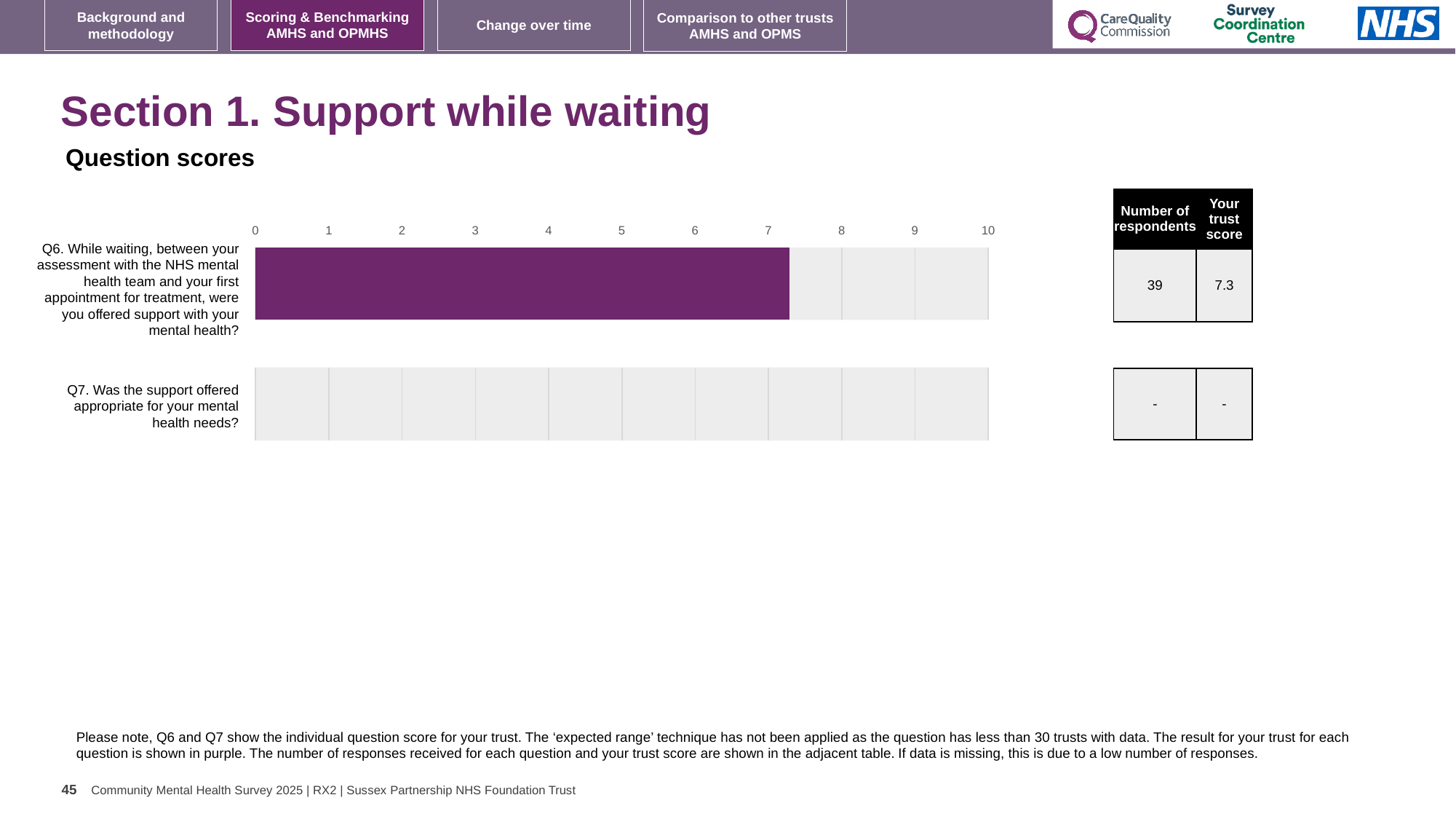
What is shown as the trust score for Q7 in the table? - Is the value of the Q6 bar greater or less than 7? greater How many respondents are shown for Q6 in the table? 39 What colour is used for the trust's result bar on the chart? purple What is the maximum value shown on the chart's horizontal axis? 10 Which question has a purple bar plotted on the chart? Q6 How many questions are listed as categories on the chart? 2 Is the value of the Q6 bar greater or less than 8? less What is the trust score for Q6 shown in the adjacent table? 7.3 What kind of chart is shown under 'Question scores'? bar chart